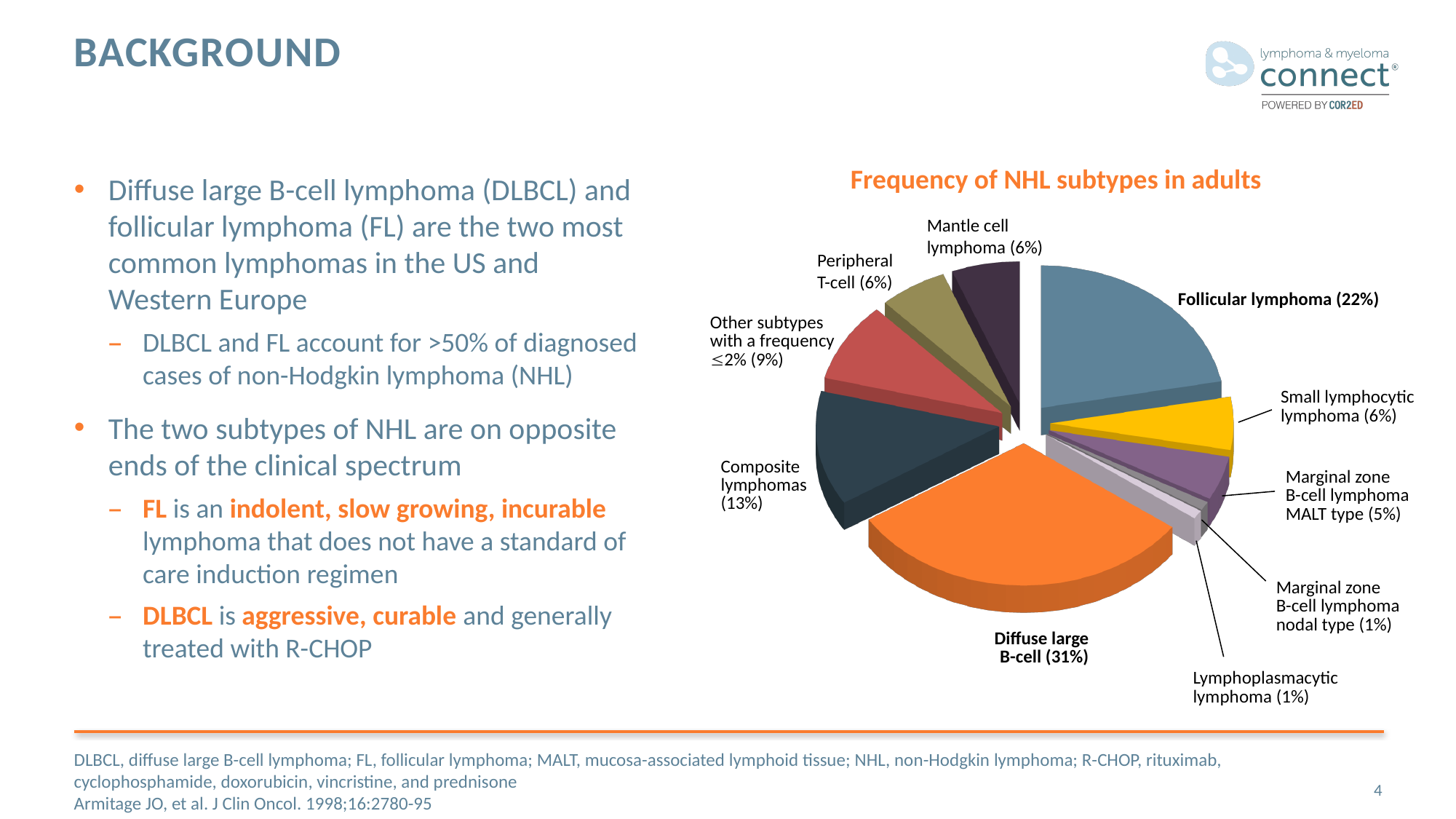
What is the difference in percentage points between Diffuse large B-cell and Follicular lymphoma? 9 Which NHL subtype has the largest share of the pie? Diffuse large B-cell What percentage is shown for Marginal zone B-cell lymphoma MALT type? 5% Which is larger, the share for Composite lymphomas or the share for Other subtypes with a frequency ≤2%? Composite lymphomas What colour is the Diffuse large B-cell slice? Orange How many slices does the pie chart have? 10 What percentage of NHL subtypes in adults is Diffuse large B-cell? 31% What kind of chart is shown on the slide? Pie chart What percentage is shown for Follicular lymphoma? 22% What percentage is shown for Lymphoplasmacytic lymphoma? 1% What percentage is shown for Composite lymphomas? 13% What is the title of the chart? Frequency of NHL subtypes in adults